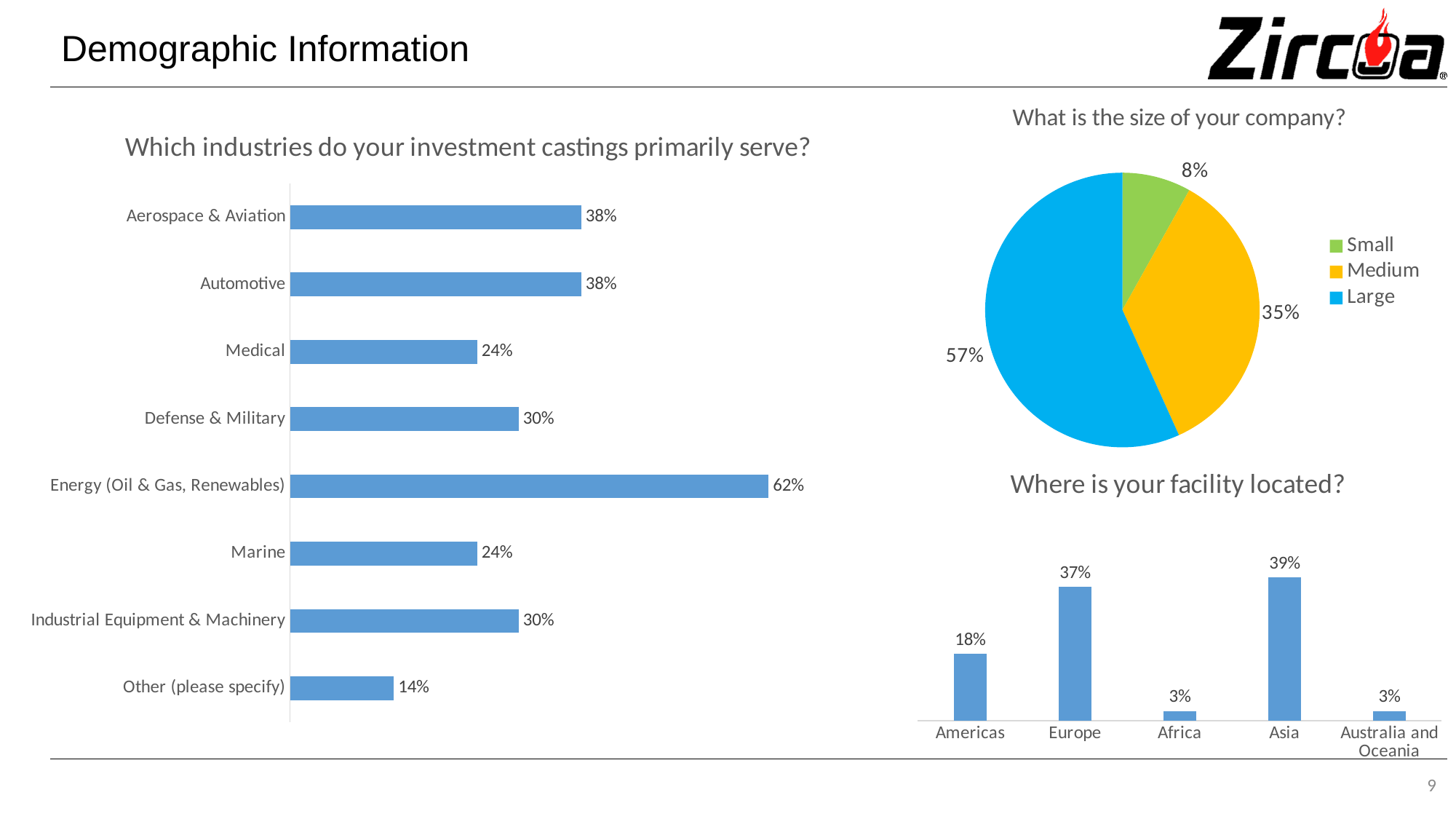
In the chart 'Where is your facility located?', what is the value for Europe? 37% How many entries does the legend of the pie chart 'What is the size of your company?' list? 3 In the pie chart 'What is the size of your company?', what share is Large? 57% In the chart 'Which industries do your investment castings primarily serve?', what is the difference between Energy (Oil & Gas, Renewables) and Medical? 38% In the chart 'Where is your facility located?', what is the difference between Asia and Americas? 21% In the chart 'Which industries do your investment castings primarily serve?', which industry has the lowest value? Other (please specify) In the chart 'Where is your facility located?', which is larger, Americas or Africa? Americas In the pie chart 'What is the size of your company?', which category has the smallest share? Small In the chart 'Which industries do your investment castings primarily serve?', how many industry categories are shown? 8 What kind of chart is 'Which industries do your investment castings primarily serve?' Bar chart In the chart 'Which industries do your investment castings primarily serve?', what is the value for Energy (Oil & Gas, Renewables)? 62% In the chart 'Where is your facility located?', which region has the highest value? Asia